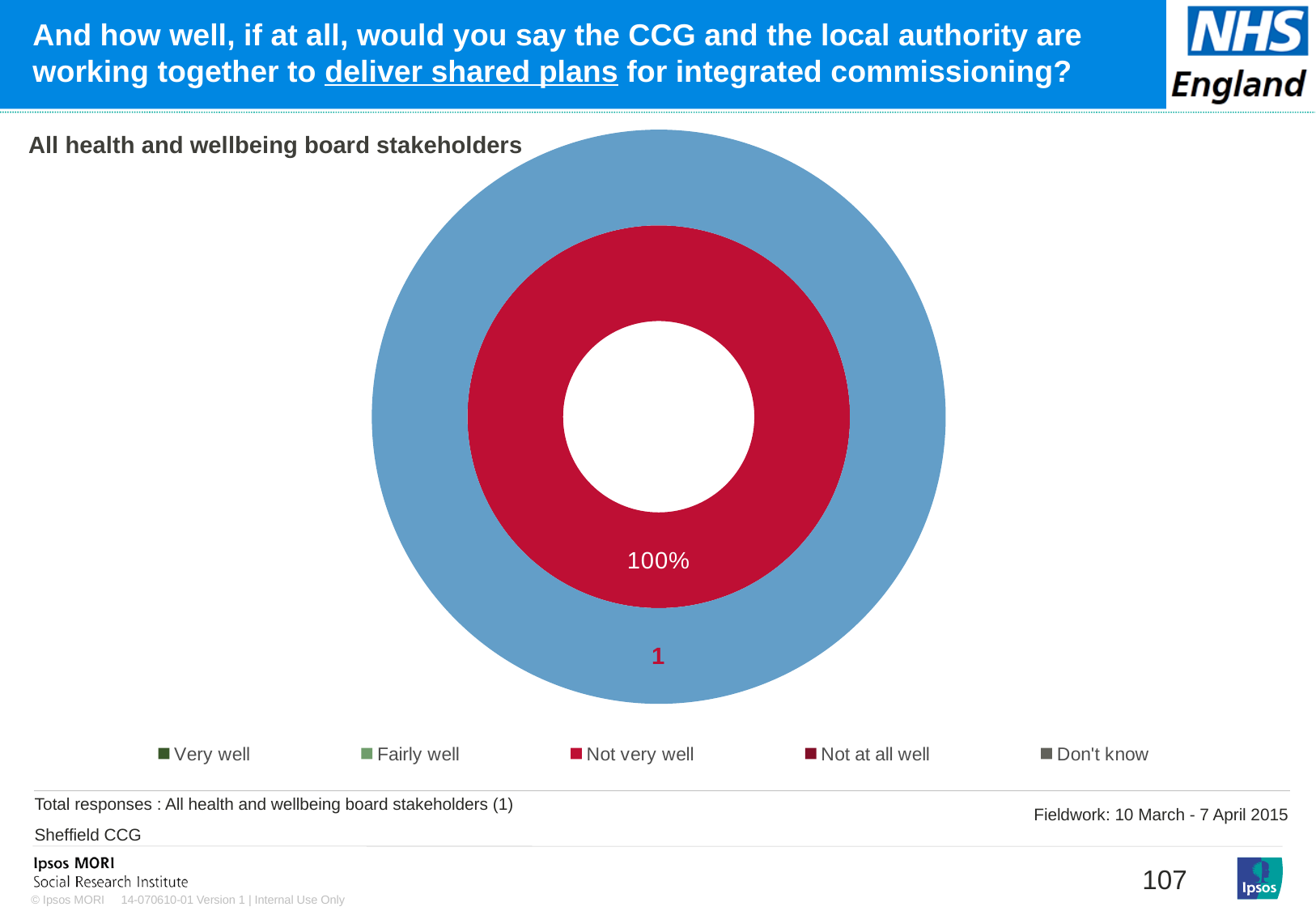
What share of the doughnut does the "Not very well" slice take up? 100% What kind of chart is shown on the slide? doughnut chart Which group of respondents does the chart cover, according to the label above it? All health and wellbeing board stakeholders What colour is the "Not very well" slice in the doughnut chart? red Which response category accounts for the whole of the doughnut chart? Not very well What percentage is shown for "Not very well"? 100% How many entries does the legend list? 5 How many response categories have a visible slice in the doughnut chart? 1 What is the total number of responses shown for all health and wellbeing board stakeholders? 1 Is the value for "Not very well" greater or less than 50%? greater